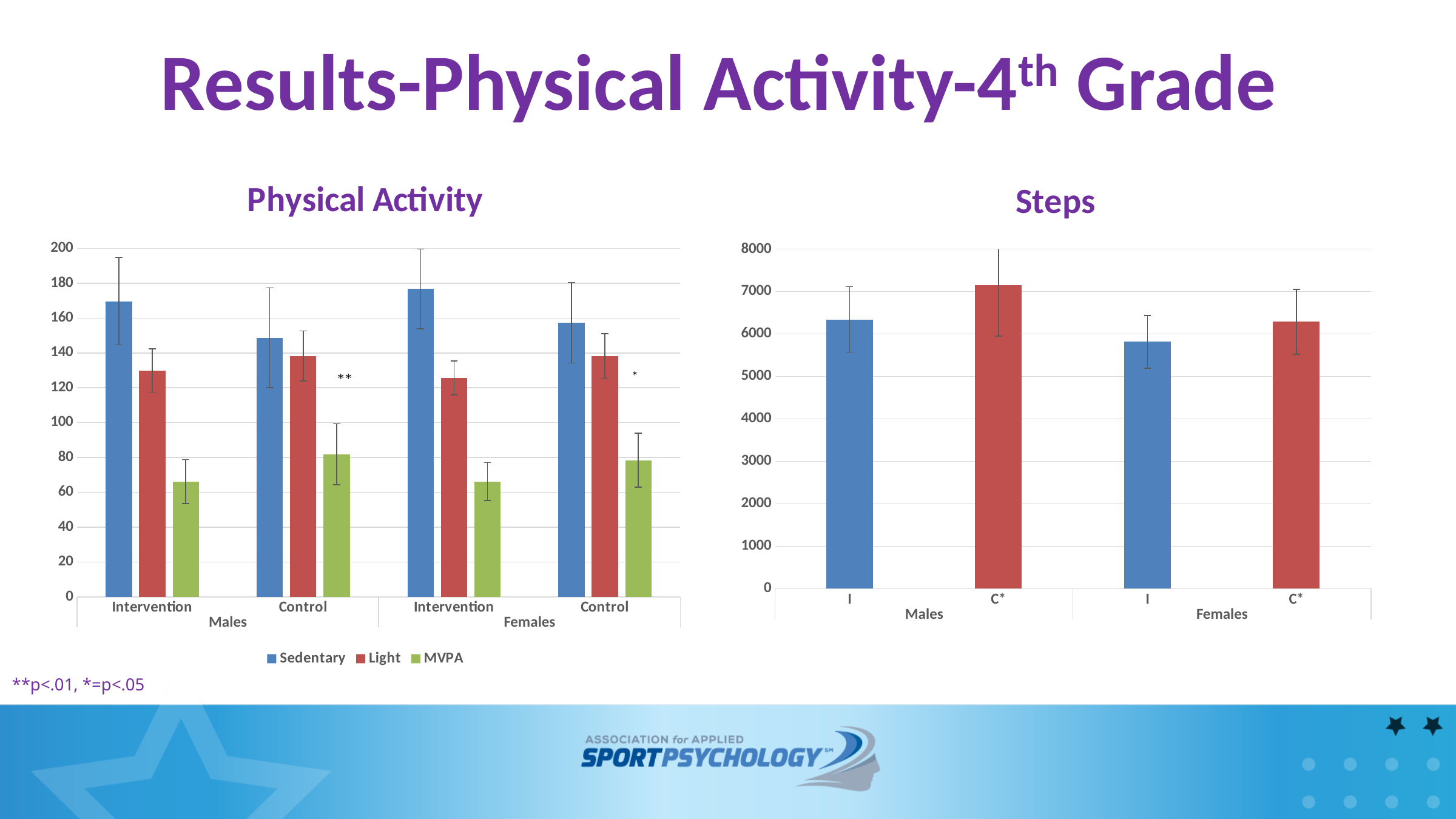
In the Physical Activity chart, is the MVPA value for Males Control greater or less than 100? less In the Steps chart, which bar is the lowest? Females I What are the series listed in the legend of the Physical Activity chart? Sedentary, Light, MVPA How many series does the legend of the Physical Activity chart list? 3 In the Steps chart, which bar is the highest? Males C* In the Physical Activity chart, which is larger: the Sedentary value for Females Intervention or the Sedentary value for Males Control? Females Intervention In the Physical Activity chart, which series has the lowest bar in every group? MVPA In the Physical Activity chart, is the Sedentary value for Males Intervention greater or less than 160? greater How many bars are plotted in the Steps chart? 4 In the Steps chart, is the value for Males C* greater or less than 7000? greater In the Steps chart, which is larger: the value for Males I or the value for Females I? Males I What kind of chart is the Physical Activity chart? bar chart